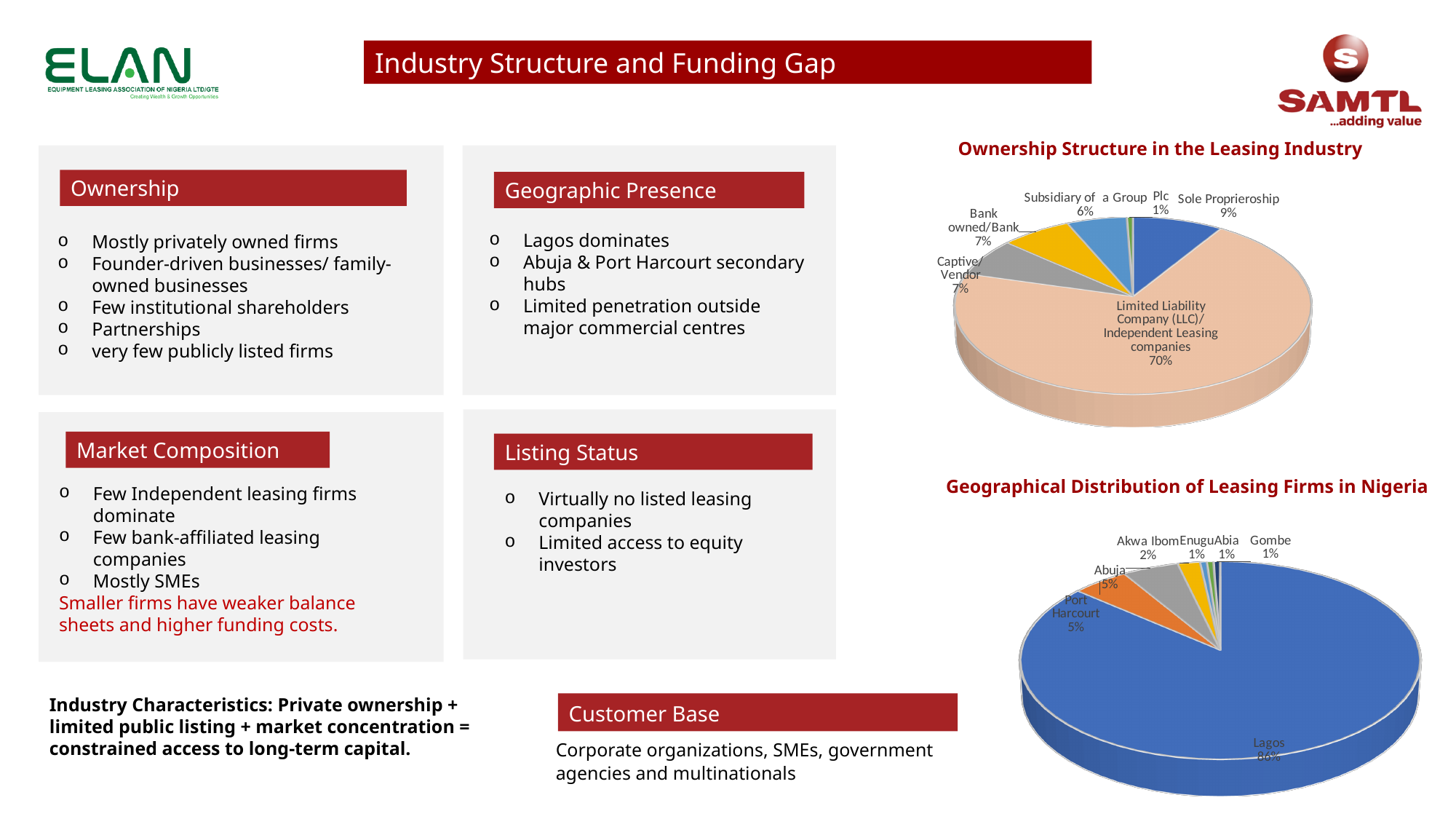
In the 'Ownership Structure in the Leasing Industry' chart, how many categories are shown? 6 In the 'Geographical Distribution of Leasing Firms in Nigeria' chart, what share is Lagos? 86% In the 'Geographical Distribution of Leasing Firms in Nigeria' chart, what share is Akwa Ibom? 2% In the 'Geographical Distribution of Leasing Firms in Nigeria' chart, which location has the largest share? Lagos In the 'Geographical Distribution of Leasing Firms in Nigeria' chart, what is the difference between Lagos and Port Harcourt? 81% In the 'Ownership Structure in the Leasing Industry' chart, what share is Limited Liability Company (LLC)/Independent Leasing companies? 70% In the 'Ownership Structure in the Leasing Industry' chart, what is the difference between Sole Proprietorship and Subsidiary of a Group? 3% In the 'Ownership Structure in the Leasing Industry' chart, what share is Sole Proprietorship? 9% In the 'Ownership Structure in the Leasing Industry' chart, which category has the smallest share? Plc In the 'Geographical Distribution of Leasing Firms in Nigeria' chart, which is larger, Abuja or Akwa Ibom? Abuja What type of chart is 'Ownership Structure in the Leasing Industry'? Pie chart In the 'Geographical Distribution of Leasing Firms in Nigeria' chart, how many locations are shown? 7